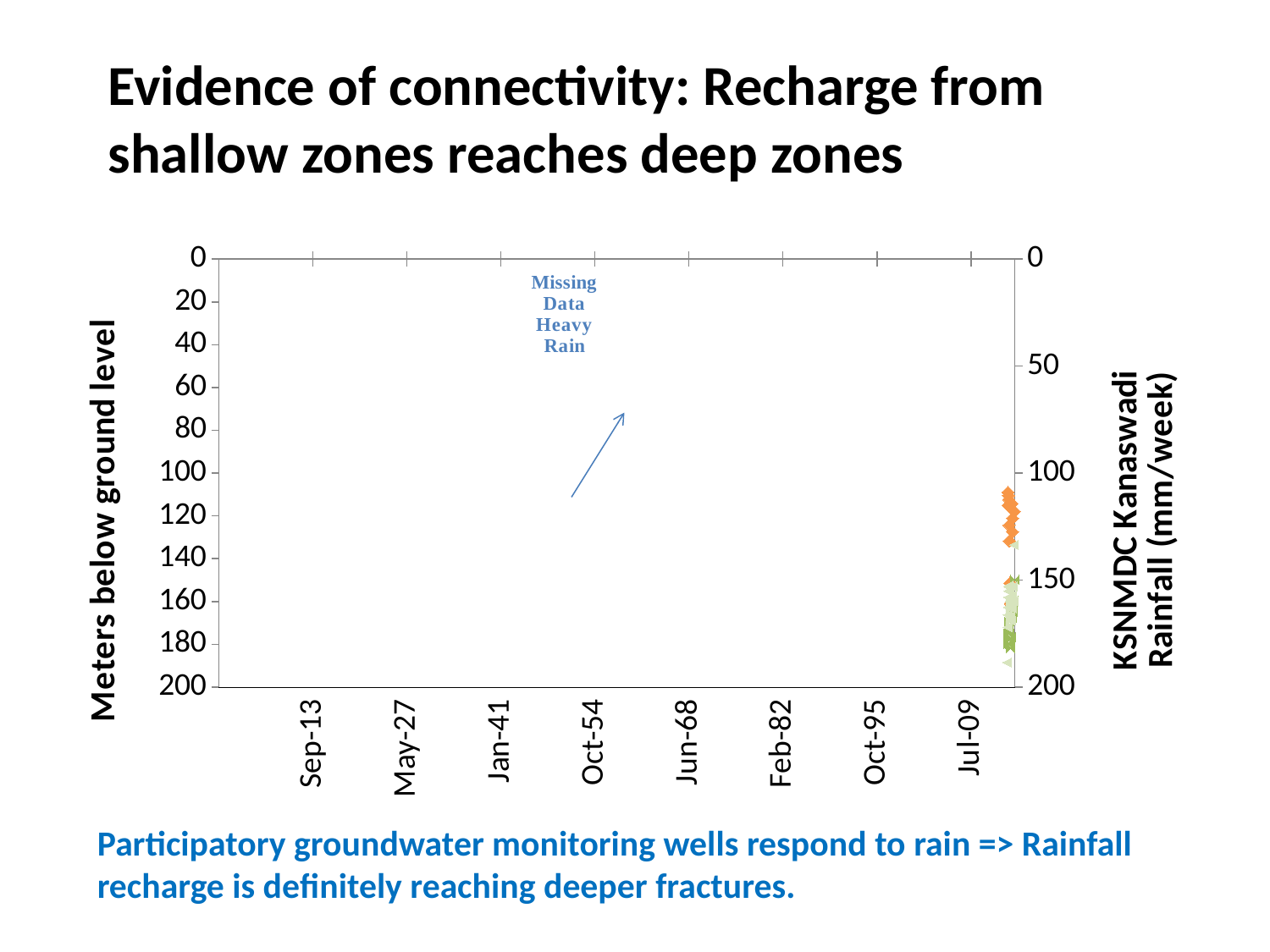
What is the label of the left vertical axis? Meters below ground level What is the label of the right vertical axis? KSNMDC Kanaswadi Rainfall (mm/week) What kind of chart is shown on the slide? scatter chart Are the green data points plotted at a level greater or less than 140 on the left axis? greater How many date labels are shown along the x axis? 8 Are the orange data points plotted at a level greater or less than 100 on the left axis? greater